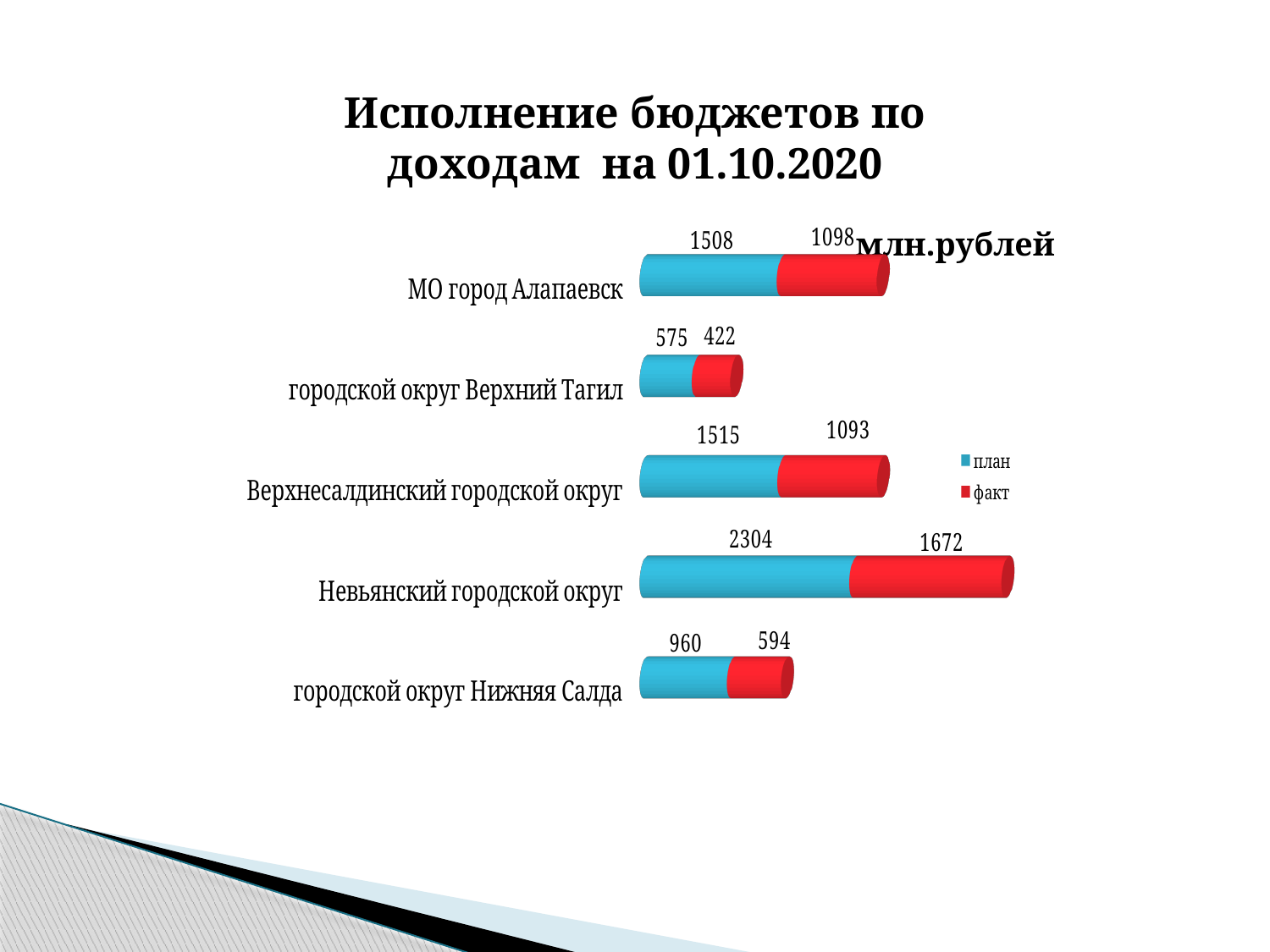
Which colour represents the факт series in the legend? Red What is the план value for Невьянский городской округ? 2304 How many categories are shown in the chart? 5 Which is larger: the факт value for Верхнесалдинский городской округ or the факт value for городской округ Нижняя Салда? Верхнесалдинский городской округ How many series does the legend list? 2 What is the факт value for МО город Алапаевск? 1098 What kind of chart is shown on the slide? Stacked bar chart What is the факт value for городской округ Верхний Тагил? 422 Which category has the highest план value? Невьянский городской округ Which category has the lowest факт value? городской округ Верхний Тагил What is the difference between the план and факт values for городской округ Нижняя Салда? 366 What is the total of the stacked bar for Невьянский городской округ? 3976